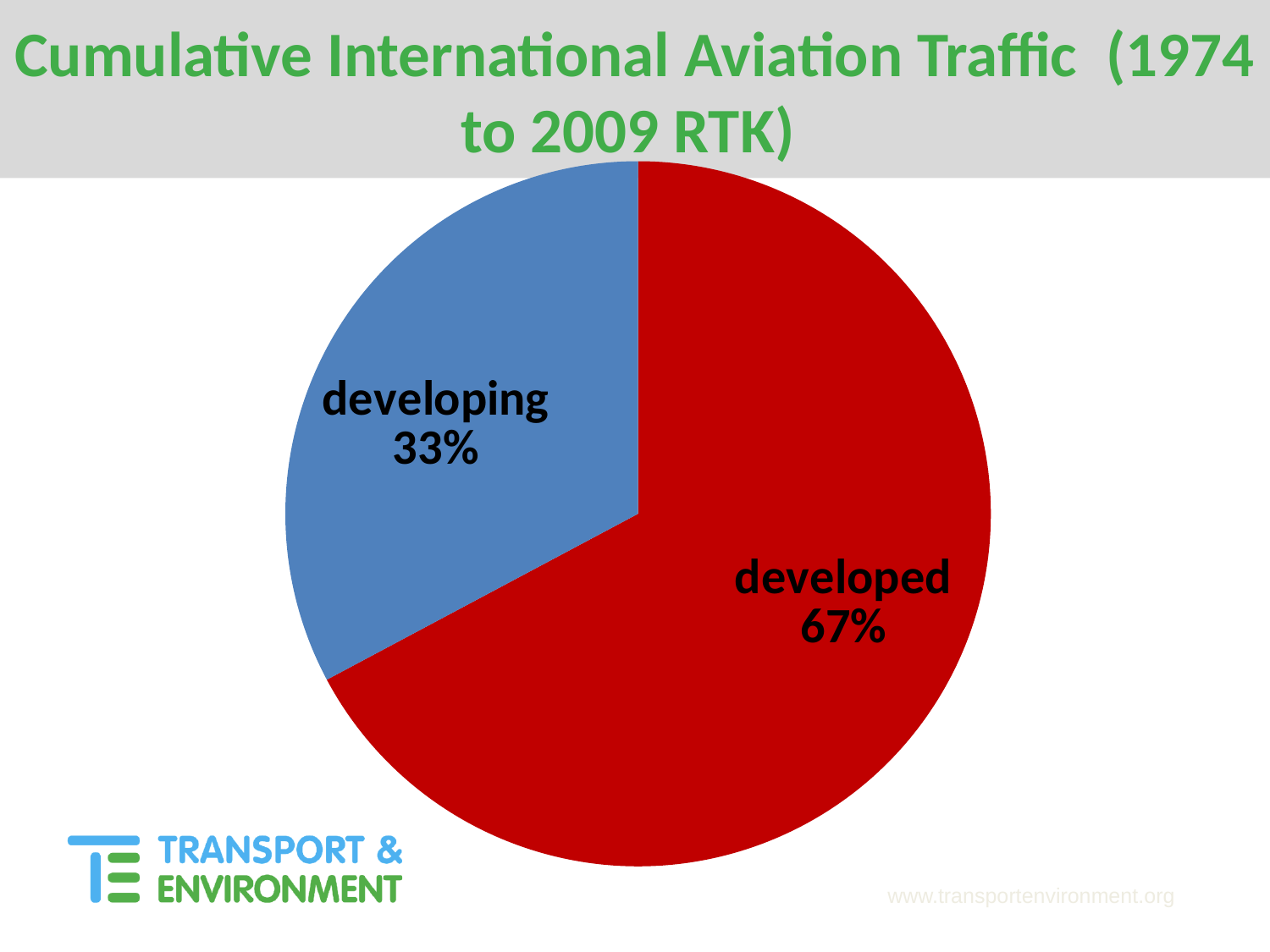
Which slice is the smallest in the pie chart? developing How many slices does the pie chart have? 2 Which slice is the largest in the pie chart? developed Which is larger, the developed slice or the developing slice? developed What share of the pie does the developed slice represent? 67% What kind of chart is shown on the slide? pie chart What colour is the developing slice? blue What share of the pie does the developing slice represent? 33% What is the difference in percentage points between the developed and developing slices? 34 What is the title of the chart? Cumulative International Aviation Traffic (1974 to 2009 RTK)